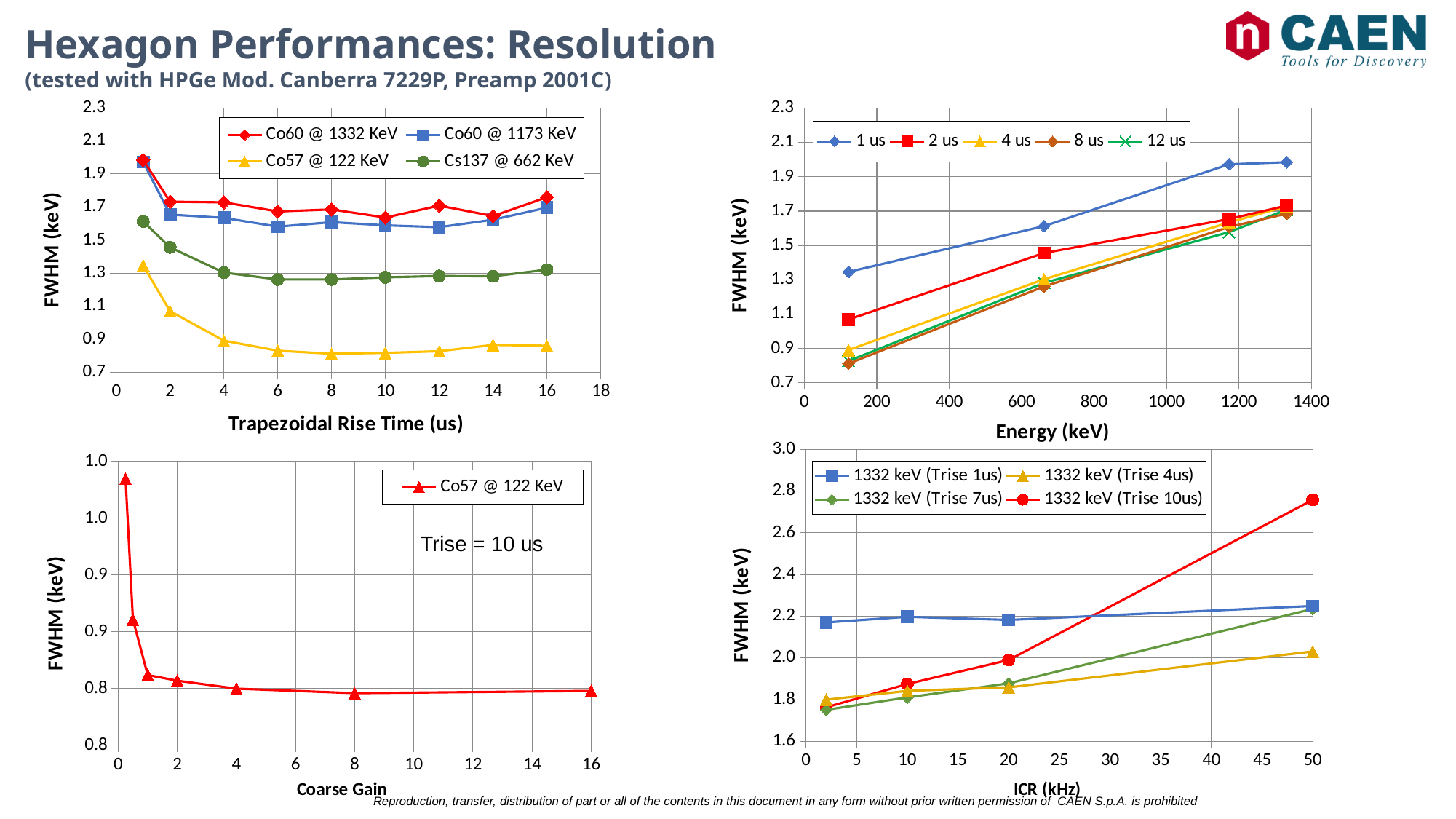
In the top-left chart (FWHM vs Trapezoidal Rise Time), is the value for Co57 @ 122 KeV at 8 us greater or less than 0.9? less In the top-right chart (FWHM vs Energy), which series has the highest FWHM values? 1 us In the top-right chart (FWHM vs Energy), is the value for the 1 us series at about 1332 keV greater or less than 1.9? greater In the bottom-right chart (FWHM vs ICR), which series has the highest FWHM at 50 kHz? 1332 keV (Trise 10us) How many series does the legend of the top-left chart (FWHM vs Trapezoidal Rise Time) list? 4 What kind of chart is the top-left chart (FWHM vs Trapezoidal Rise Time)? line chart In the top-left chart (FWHM vs Trapezoidal Rise Time), do the Co57 @ 122 KeV values rise or fall between 1 us and 4 us? fall In the top-right chart (FWHM vs Energy), do the FWHM values rise or fall as energy increases? rise How many series does the legend of the top-right chart (FWHM vs Energy) list? 5 What series does the legend of the bottom-left chart (FWHM vs Coarse Gain) list? Co57 @ 122 KeV In the top-left chart (FWHM vs Trapezoidal Rise Time), which series has the lowest FWHM values? Co57 @ 122 KeV In the bottom-right chart (FWHM vs ICR), is the value for 1332 keV (Trise 10us) at 50 kHz greater or less than 2.6? greater